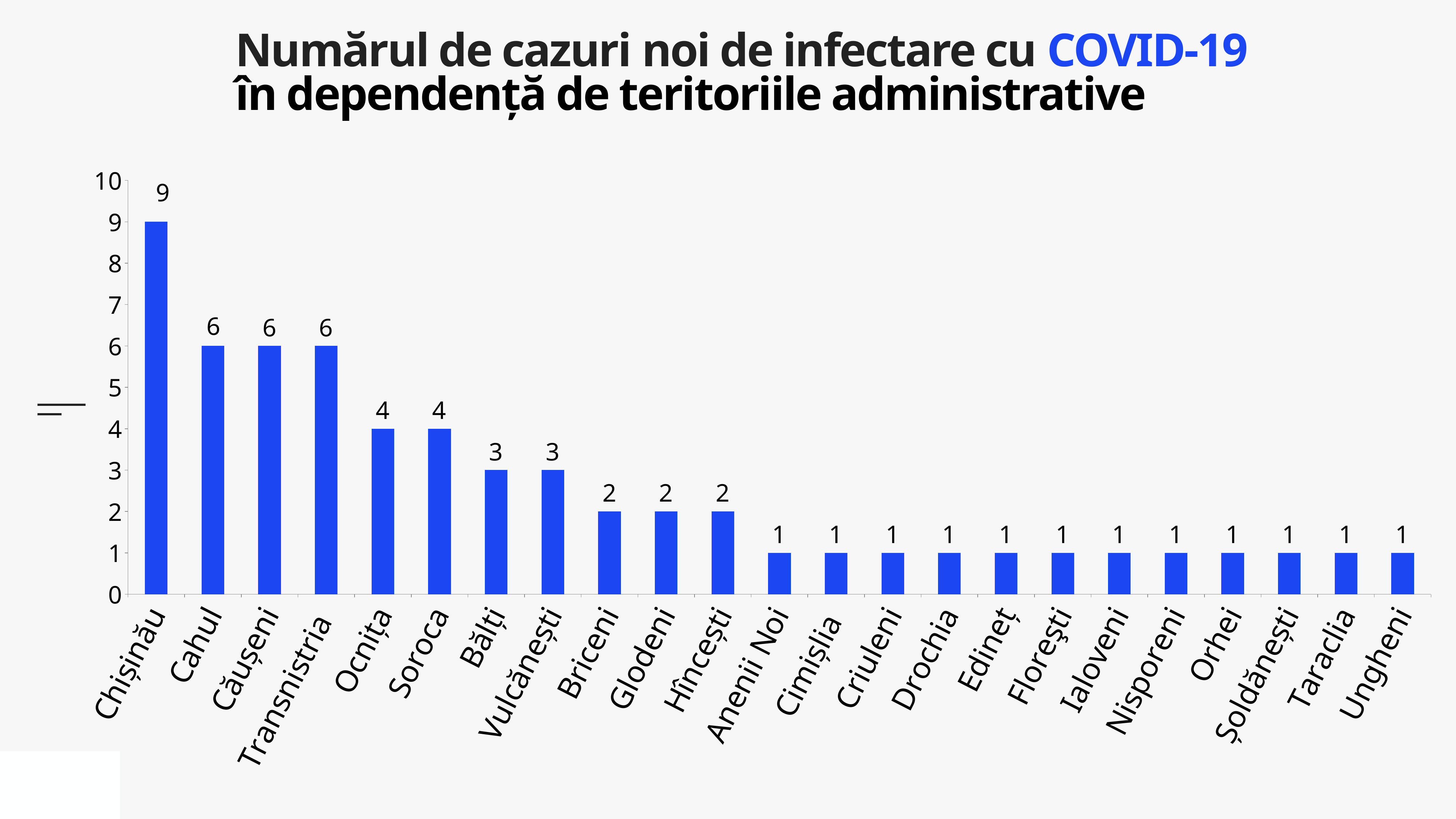
Which category has the highest value? Chișinău What is the difference between the values for Ocnița and Bălți? 1 What is the value for Transnistria? 6 What is the value for Chișinău? 9 Do the values rise or fall from left to right along the x axis? fall How many categories are shown on the x axis? 23 What is the value for Hîncești? 2 What is the value for Soroca? 4 What is the difference between the values for Chișinău and Cahul? 3 What kind of chart is shown on the slide? bar chart What is the highest value shown on the y axis? 10 Which is larger, the value for Căușeni or the value for Vulcănești? Căușeni